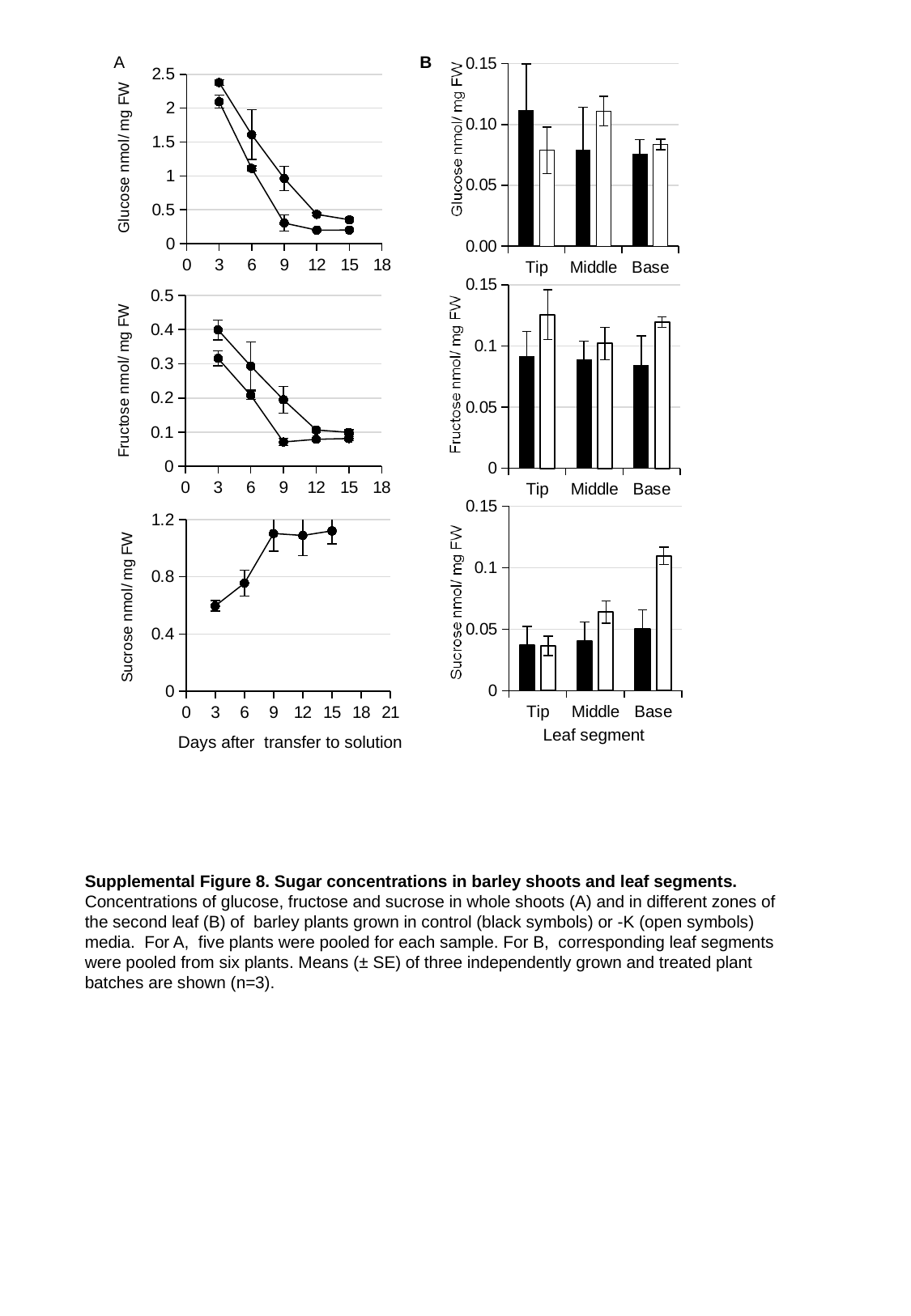
In the sucrose bar chart in panel B (bottom right), is the open (white) bar for Base greater or less than 0.1? greater In the sucrose line chart in panel A (bottom left), do the values rise or fall as days after transfer increase? rise In the sucrose line chart in panel A (bottom left), is the value at day 15 greater or less than 0.8? greater In the fructose bar chart in panel B (middle right), for the Tip segment, which bar is larger, the black bar or the open (white) bar? open (white) bar In the sucrose bar chart in panel B (bottom right), which leaf segment has the highest open (white) bar? Base In the glucose line chart in panel A (top left), what kind of chart is it? line chart In the fructose line chart in panel A (middle left), do the values rise or fall as days after transfer increase? fall In the sucrose line chart in panel A (bottom left), how many data points are plotted? 5 In the glucose bar chart in panel B (top right), which leaf segment has the highest black bar? Tip In the sucrose bar chart in panel B (bottom right), what kind of chart is it? bar chart In the glucose bar chart in panel B (top right), how many leaf segment categories are shown on the x axis? 3 In the glucose line chart in panel A (top left), is the value of the upper series at day 3 greater or less than 2? greater